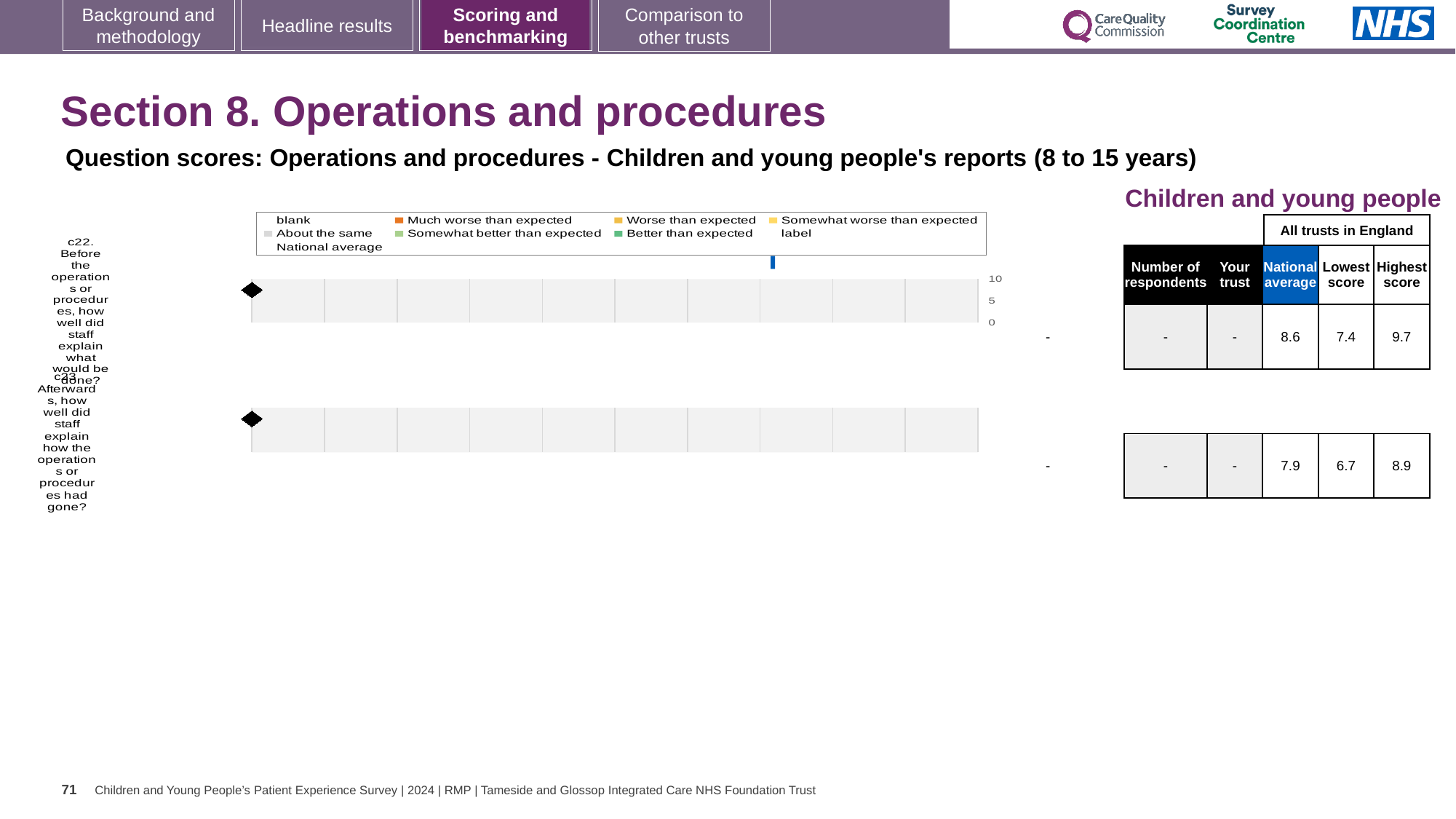
What is the highest value shown on the chart's axis? 10 In the table next to the chart, what is the national average for c22 (Before the operations or procedures, how well did staff explain what would be done?)? 8.6 How many questions (categories) are plotted on the chart? 2 In the table next to the chart, what is the lowest score for c23? 6.7 What kind of chart is shown on the slide? bar chart In the table next to the chart, what is the national average for c23 (Afterwards, how well did staff explain how the operations or procedures had gone?)? 7.9 Which legend entry is shown in orange on the chart? Much worse than expected In the table next to the chart, which question has the higher national average, c22 or c23? c22 How many entries does the chart legend list? 9 In the table next to the chart, what is the lowest score for c22? 7.4 In the table next to the chart, what is the highest score for c23? 8.9 In the table next to the chart, what is the highest score for c22? 9.7